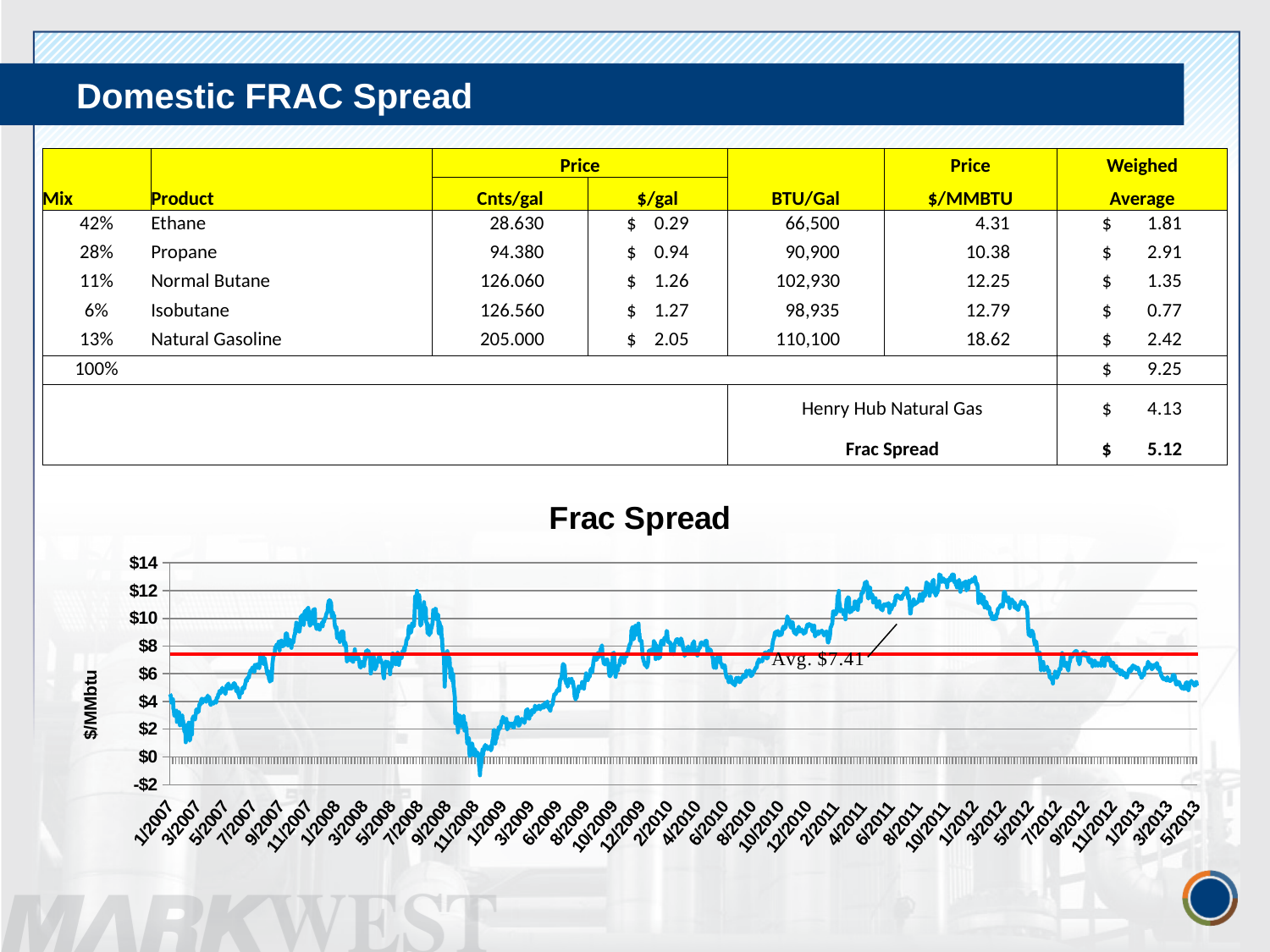
On the Frac Spread chart, is the value around 10/2011 greater or less than $10? greater On the Frac Spread chart, does the line rise or fall between 10/2011 and 7/2012? fall On the Frac Spread chart, is the value at 1/2007 greater or less than $6? less What average value is annotated on the Frac Spread chart? Avg. $7.41 On the Frac Spread chart, is the value at 5/2013 greater or less than $8? less What is the title of the chart on the slide? Frac Spread What is the label on the vertical axis of the Frac Spread chart? $/MMbtu On the Frac Spread chart, which is larger, the value around 10/2011 or the value at 5/2013? 10/2011 What kind of chart is the Frac Spread chart? line chart In which year does the Frac Spread line reach its lowest point? 2008 On the Frac Spread chart, does the line rise or fall between 1/2007 and 11/2007? rise